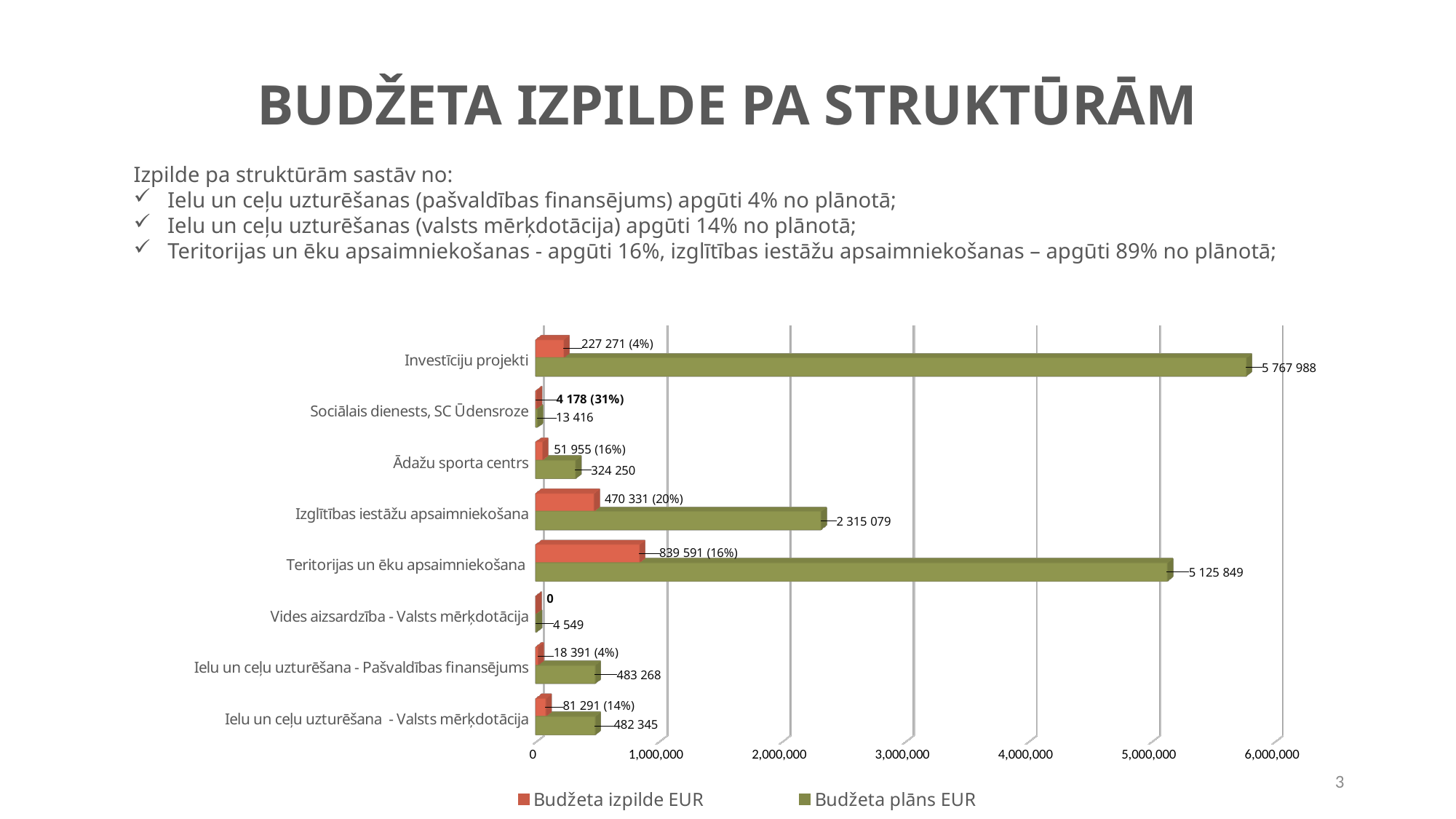
What is the Budžeta plāns EUR value for Investīciju projekti? 5 767 988 What is the Budžeta izpilde EUR value for Vides aizsardzība - Valsts mērķdotācija? 0 Which category has the lowest Budžeta plāns EUR value? Vides aizsardzība - Valsts mērķdotācija Which category has the highest Budžeta izpilde EUR value? Teritorijas un ēku apsaimniekošana What is the Budžeta izpilde EUR value for Teritorijas un ēku apsaimniekošana? 839 591 (16%) What is the Budžeta plāns EUR value for Izglītības iestāžu apsaimniekošana? 2 315 079 How many categories are shown on the chart? 8 How many series does the legend list? 2 What is the difference between the Budžeta plāns EUR and Budžeta izpilde EUR values for Teritorijas un ēku apsaimniekošana? 4 286 258 Which category has the highest Budžeta plāns EUR value? Investīciju projekti Which is larger: the Budžeta plāns EUR value for Ielu un ceļu uzturēšana - Pašvaldības finansējums or for Ādažu sporta centrs? Ielu un ceļu uzturēšana - Pašvaldības finansējums What kind of chart is shown on the slide? Bar chart